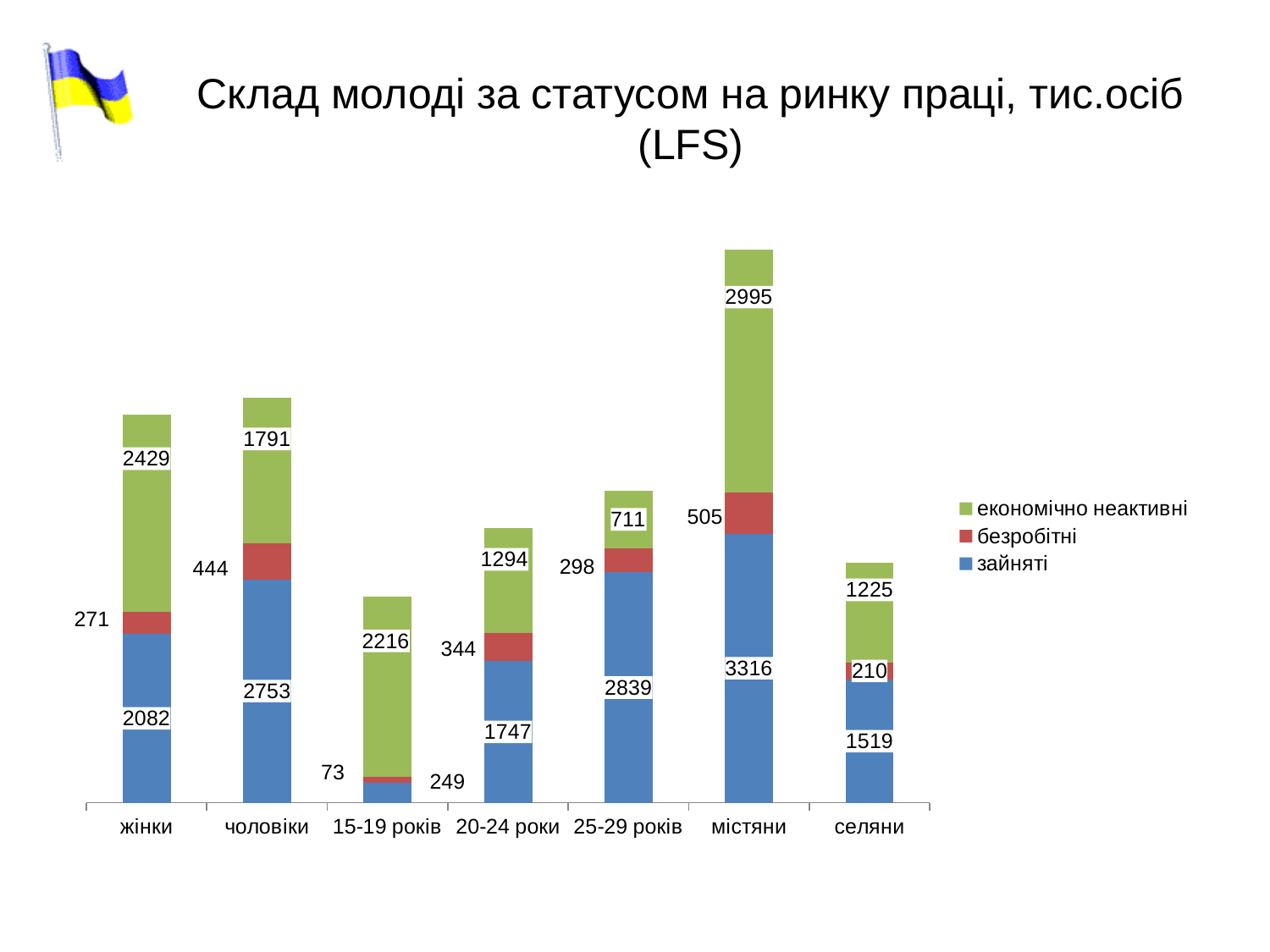
Which is larger: економічно неактивні for жінки or for чоловіки? жінки What is the value of економічно неактивні for жінки? 2429 What is the value of безробітні for селяни? 210 How many categories are shown on the x axis? 7 What is the total of the stacked bar for селяни? 2954 Which category has the lowest value for зайняті? 15-19 років What is the value of зайняті for містяни? 3316 What is the difference between зайняті for чоловіки and зайняті for жінки? 671 How many series does the legend list? 3 Which category has the lowest value for економічно неактивні? 25-29 років Which category has the highest value for зайняті? містяни What is the value of безробітні for чоловіки? 444